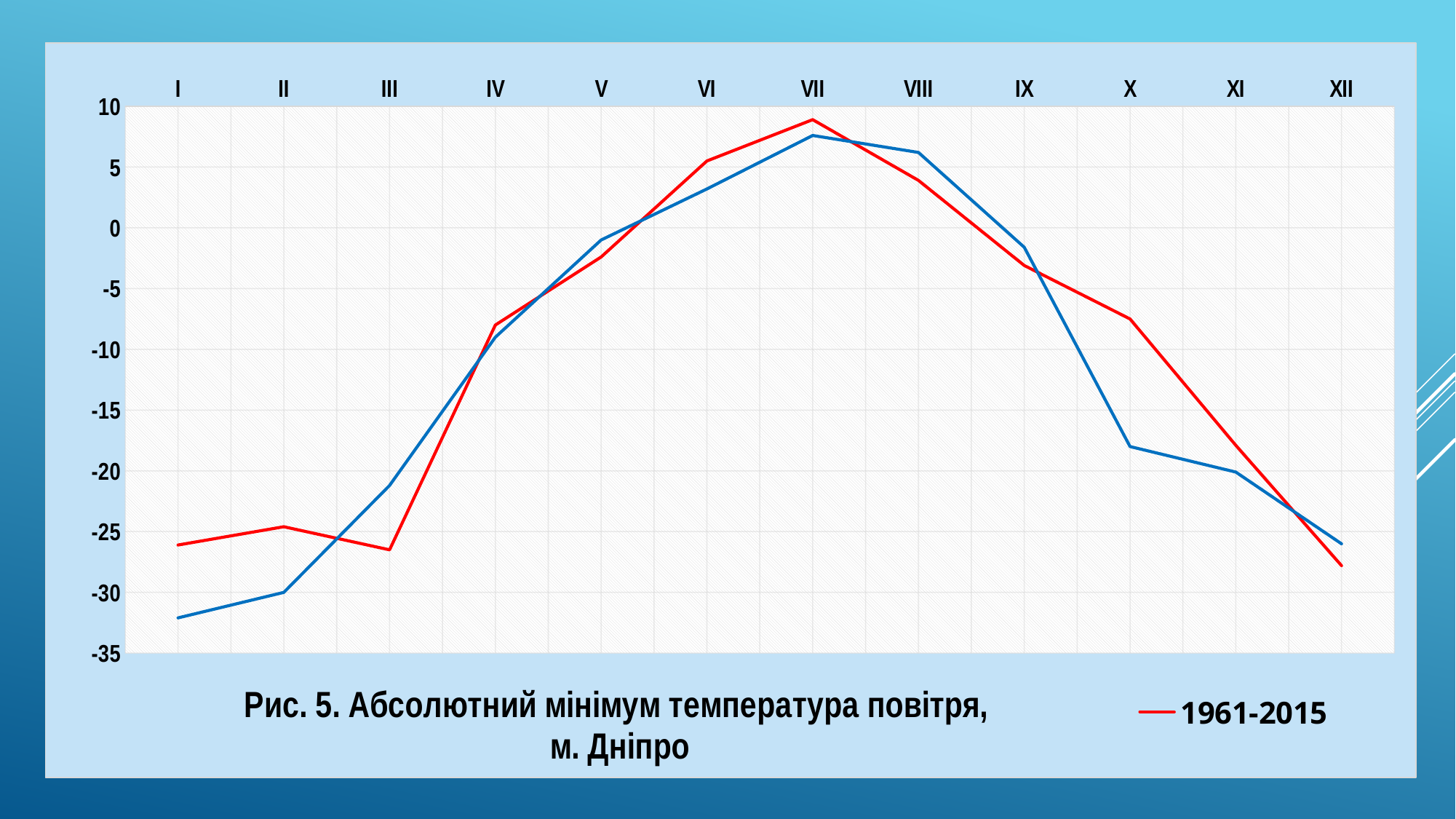
What kind of chart is shown on the slide? line chart Is the 1961-2015 value for month XI greater or less than -15? less Is the 1961-2015 value for month VII greater or less than 5? greater How many months (categories) are shown along the x axis? 12 How many series does the legend list? 1 For the 1961-2015 series, which month has the larger value, II or III? II What colour is the line for the 1961-2015 series? red For the 1961-2015 series, which month has the larger value, VII or VIII? VII Do the 1961-2015 values rise or fall from month VII to month XII? fall In which month does the 1961-2015 series reach its highest value? VII In which month does the 1961-2015 series reach its lowest value? XII Is the 1961-2015 value for month X greater or less than -10? greater